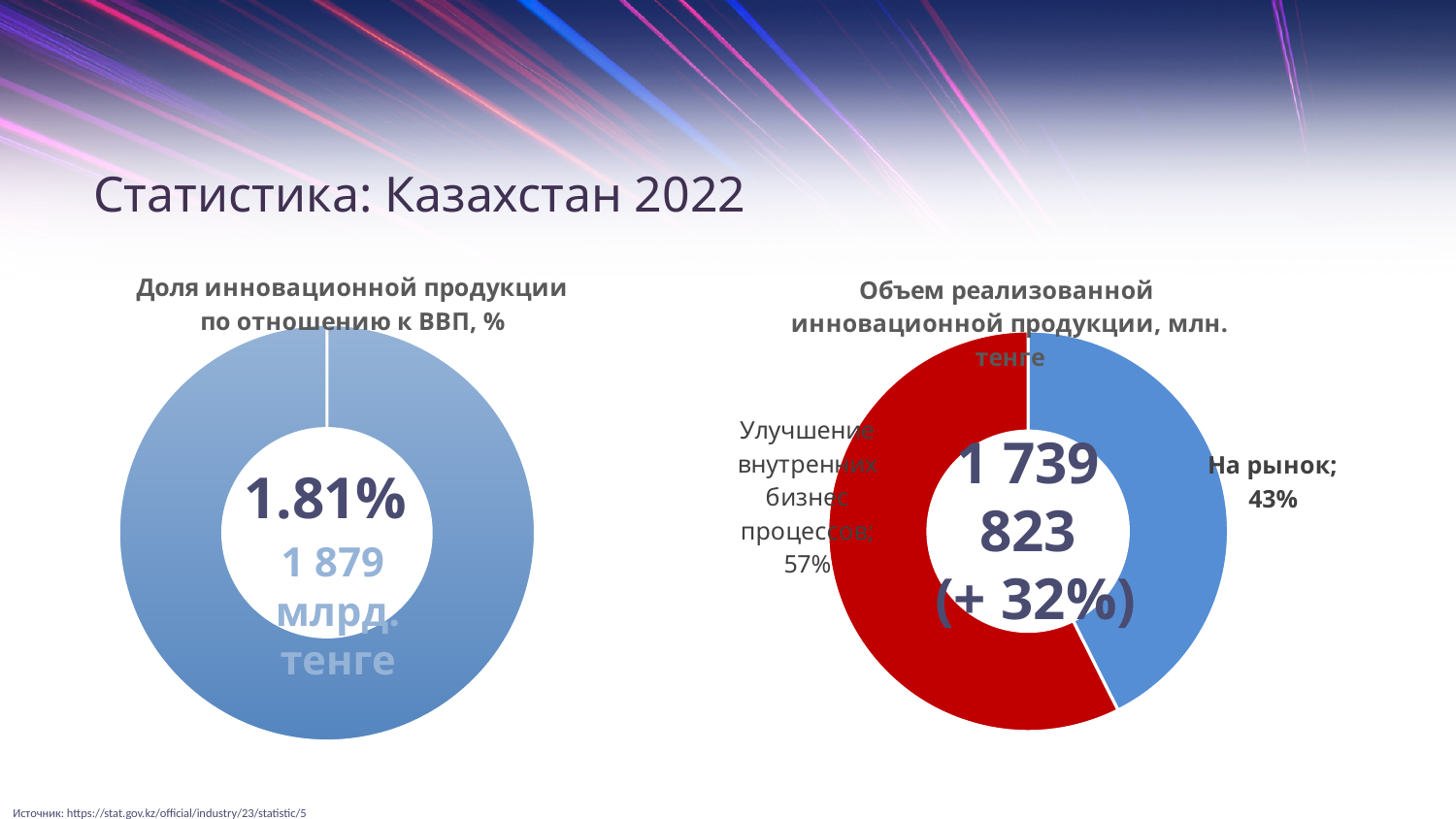
In the right-hand chart "Объем реализованной инновационной продукции", what share is labelled for "На рынок"? 43% In the right-hand chart "Объем реализованной инновационной продукции", which slice is the smallest? На рынок In the right-hand chart "Объем реализованной инновационной продукции", what is the difference in percentage points between the "Улучшение внутренних бизнес процессов" slice and the "На рынок" slice? 14 percentage points What percentage is printed in the centre of the left-hand chart "Доля инновационной продукции по отношению к ВВП, %"? 1.81% In the right-hand chart "Объем реализованной инновационной продукции", what colour is the "На рынок" slice? blue What total value is printed in the centre of the right-hand chart "Объем реализованной инновационной продукции"? 1 739 823 (+ 32%) In the right-hand chart "Объем реализованной инновационной продукции", which slice is the largest? Улучшение внутренних бизнес процессов In the right-hand chart "Объем реализованной инновационной продукции", what share is labelled for "Улучшение внутренних бизнес процессов"? 57% In the right-hand chart "Объем реализованной инновационной продукции", which is larger: "На рынок" or "Улучшение внутренних бизнес процессов"? Улучшение внутренних бизнес процессов What amount in tenge is printed in the centre of the left-hand chart "Доля инновационной продукции по отношению к ВВП, %"? 1 879 млрд. тенге How many slices does the right-hand chart "Объем реализованной инновационной продукции" have? 2 What kind of chart is the right-hand chart titled "Объем реализованной инновационной продукции, млн. тенге"? doughnut (pie) chart